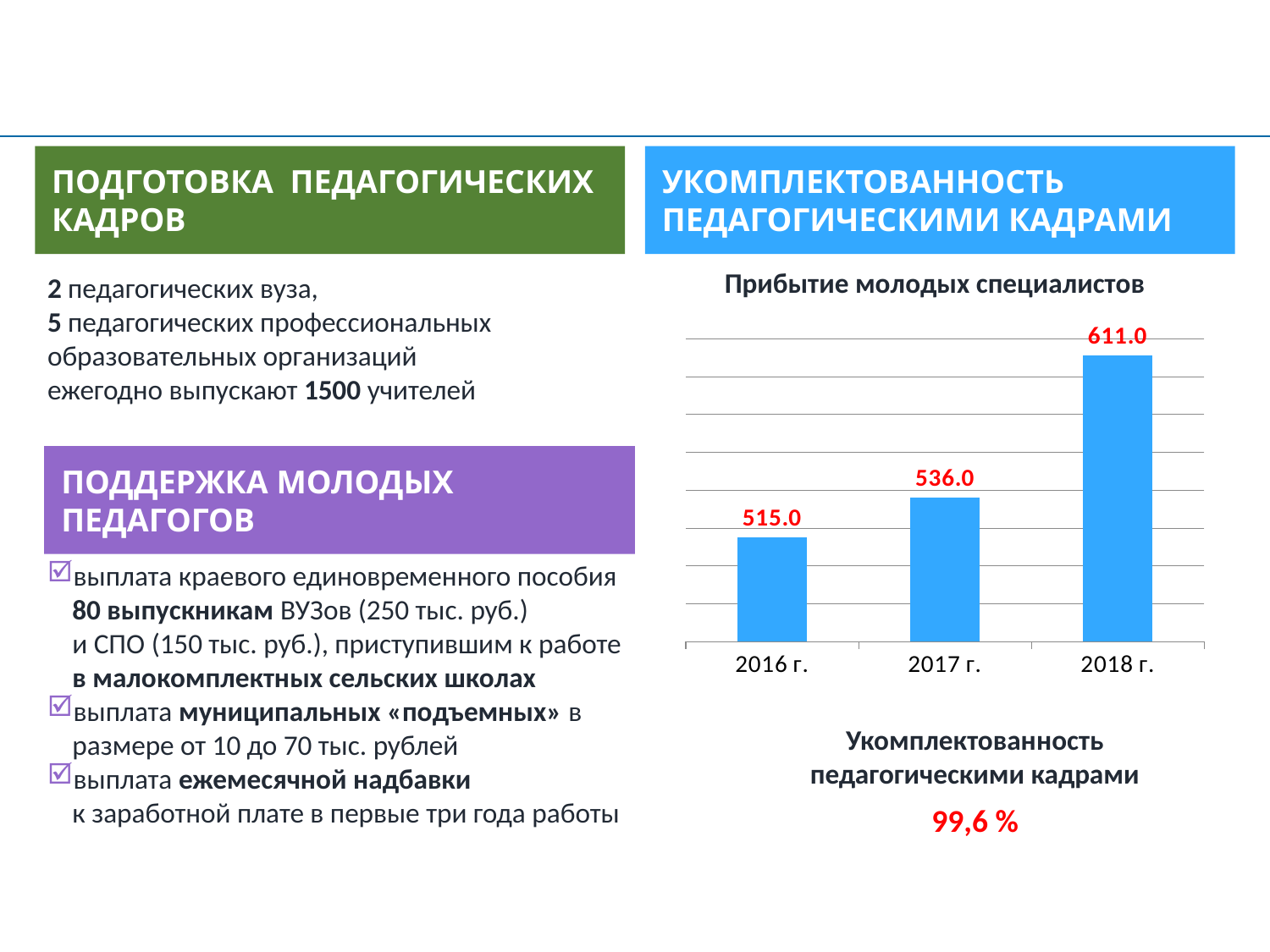
What is the value for 2016 г. in the chart 'Прибытие молодых специалистов'? 515.0 What is the title of the chart on the slide? Прибытие молодых специалистов What is the difference between the values for 2017 г. and 2016 г. in the chart 'Прибытие молодых специалистов'? 21.0 Which year has the lowest value in the chart 'Прибытие молодых специалистов'? 2016 г. Which year has the highest value in the chart 'Прибытие молодых специалистов'? 2018 г. How many years are shown on the x axis of the chart 'Прибытие молодых специалистов'? 3 What kind of chart is 'Прибытие молодых специалистов'? bar chart Which is larger in the chart 'Прибытие молодых специалистов': the value for 2016 г. or 2018 г.? 2018 г. Do the values in the chart 'Прибытие молодых специалистов' rise or fall from 2016 г. to 2018 г.? rise What is the value for 2018 г. in the chart 'Прибытие молодых специалистов'? 611.0 What is the value for 2017 г. in the chart 'Прибытие молодых специалистов'? 536.0 What is the difference between the values for 2018 г. and 2017 г. in the chart 'Прибытие молодых специалистов'? 75.0